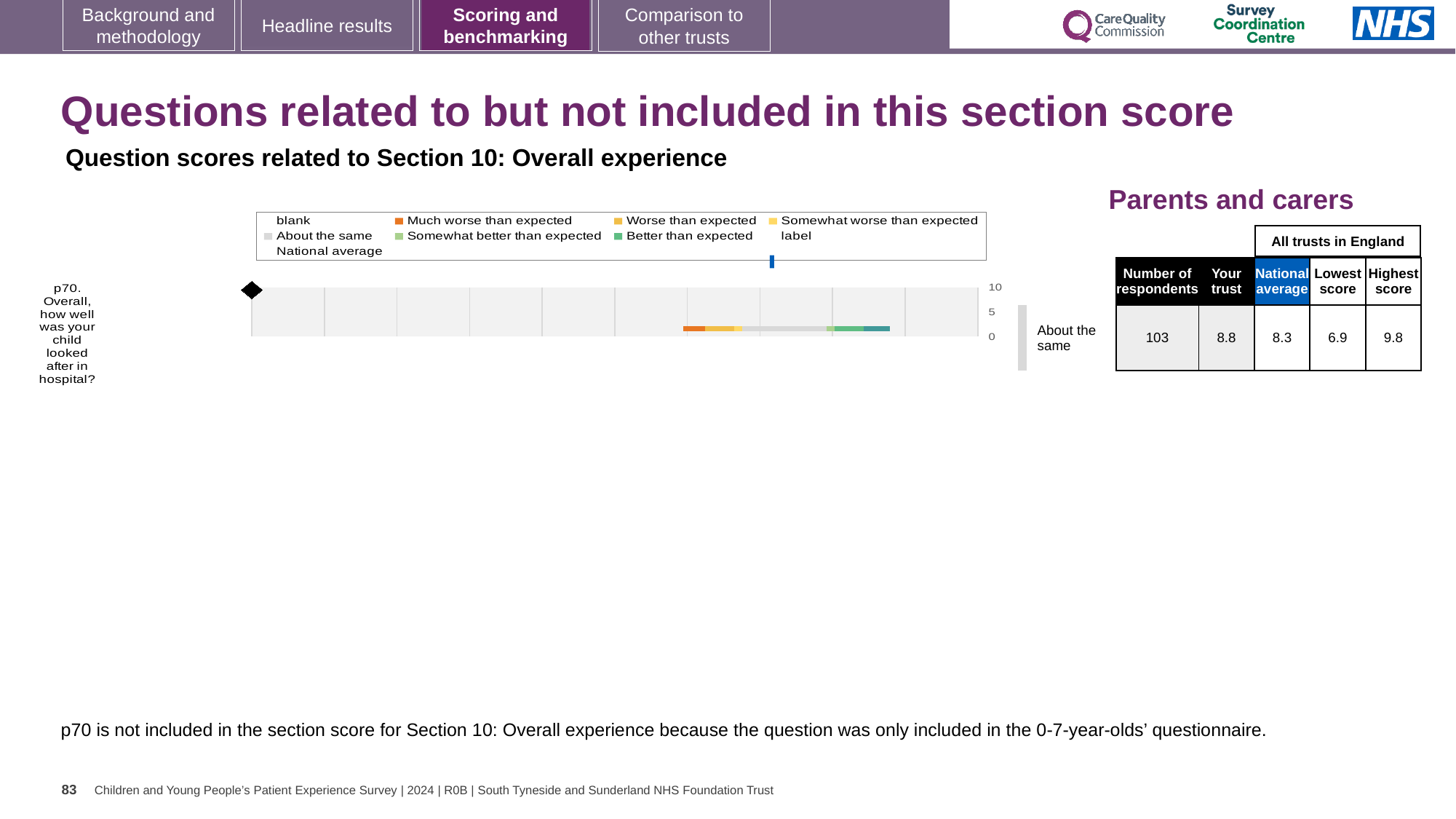
In the table next to the chart, what is the highest score among all trusts in England for p70? 9.8 Which comparison category is shown for question p70 in the chart? About the same Which respondent group does the chart and table relate to? Parents and carers In the table next to the chart, what is the lowest score among all trusts in England for p70? 6.9 How many respondents answered question p70? 103 What is the difference between the 'Your trust' score and the national average for p70? 0.5 In the table next to the chart, what is the 'Your trust' score for p70? 8.8 What kind of chart is shown on the slide? bar chart How many questions are plotted in the chart? 1 In the table next to the chart, what is the national average score for p70? 8.3 Which is higher for p70, the 'Your trust' score or the national average? Your trust What is the difference between the highest and lowest scores among all trusts in England for p70? 2.9